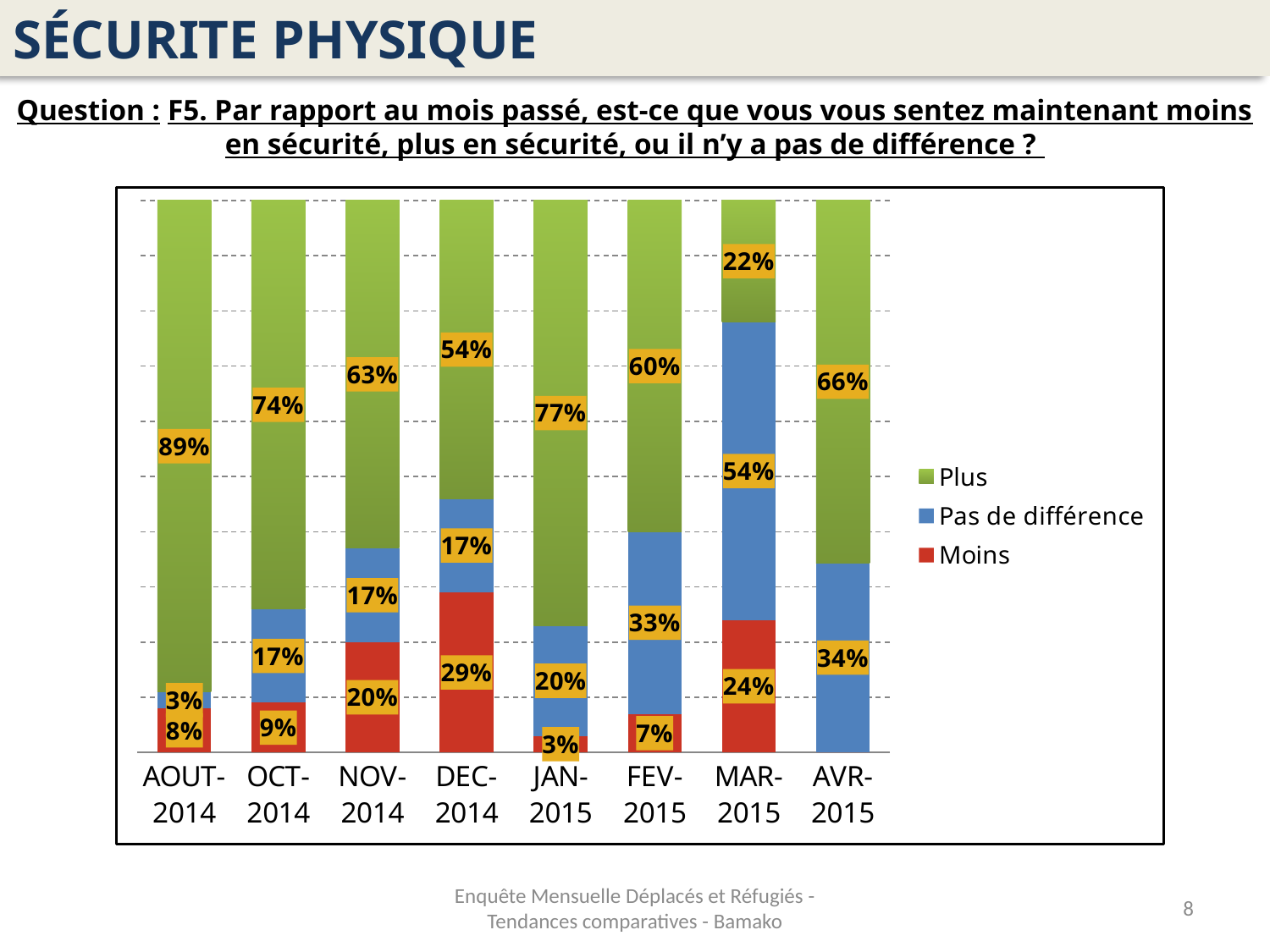
In which month is the 'Plus' value the lowest? MAR-2015 What is the value of 'Pas de différence' for MAR-2015? 54% In which month is the 'Moins' value the highest? DEC-2014 Which series is shown in red? Moins What is the value of 'Moins' for DEC-2014? 29% How many series does the legend list? 3 How many months (categories) are shown on the x axis? 8 Which is larger: the 'Pas de différence' value for FEV-2015 or for JAN-2015? FEV-2015 What type of chart is shown on the slide? stacked bar chart What is the value of 'Plus' for AOUT-2014? 89% Does the 'Plus' value rise or fall from AOUT-2014 to DEC-2014? fall What is the difference between the 'Plus' values for AOUT-2014 and OCT-2014? 15%